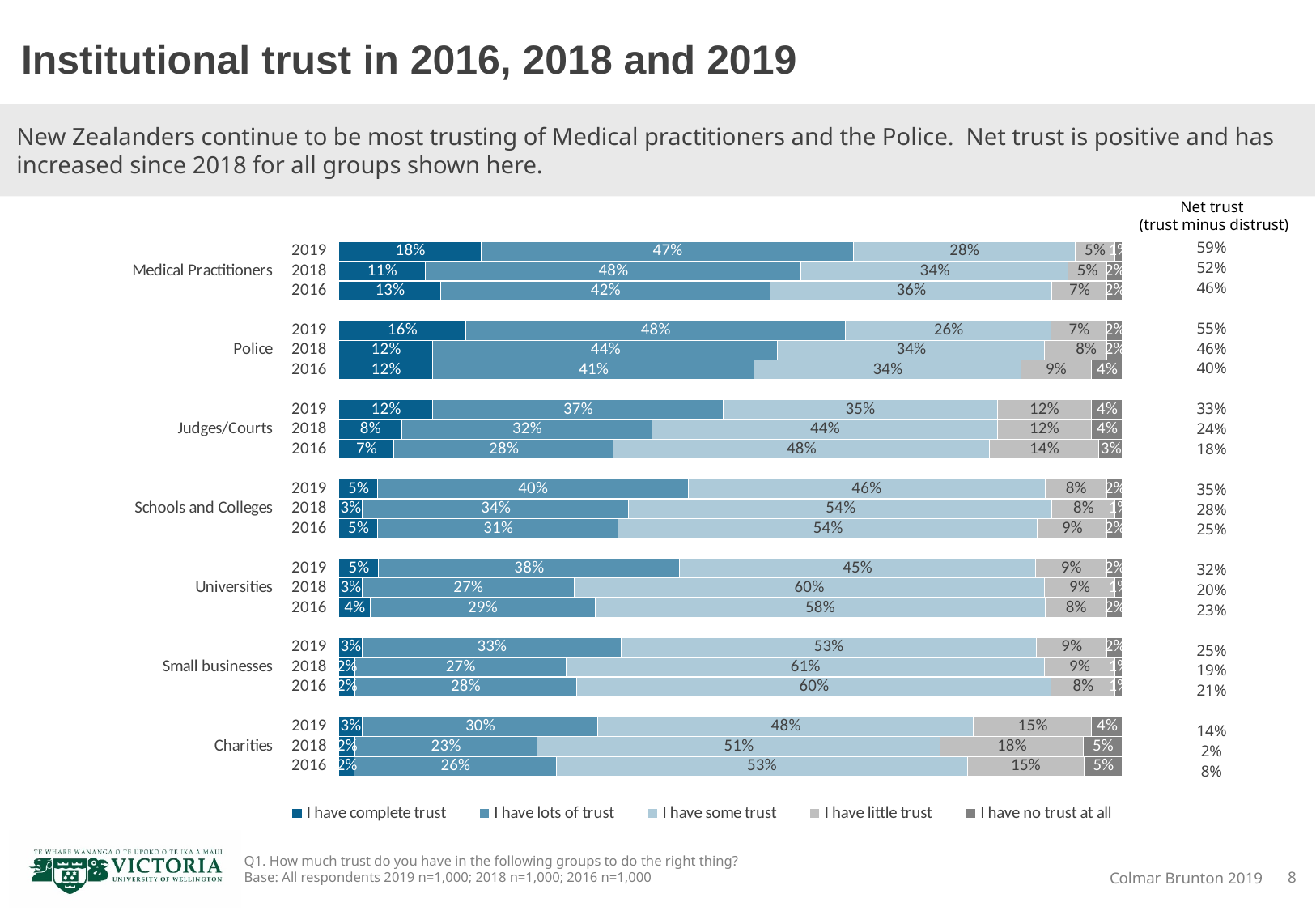
What type of chart is shown on the slide? Stacked bar chart By how many percentage points did net trust in Judges/Courts increase from 2016 to 2019? 15 percentage points Does net trust in Medical Practitioners rise or fall from 2016 to 2019? Rises Which institution has the lowest net trust in 2018? Charities What percentage of respondents said "I have lots of trust" in Medical Practitioners in 2019? 47% How many institutions are shown in the chart? 7 What is the net trust value for the Police in 2019? 55% How many trust levels does the legend list? 5 In 2019, which had a larger share of "I have lots of trust": the Police or Judges/Courts? Police What percentage of respondents said "I have some trust" in Charities in 2018? 51% What percentage of respondents said "I have little trust" in Charities in 2018? 18% Which institution has the highest net trust in 2019? Medical Practitioners